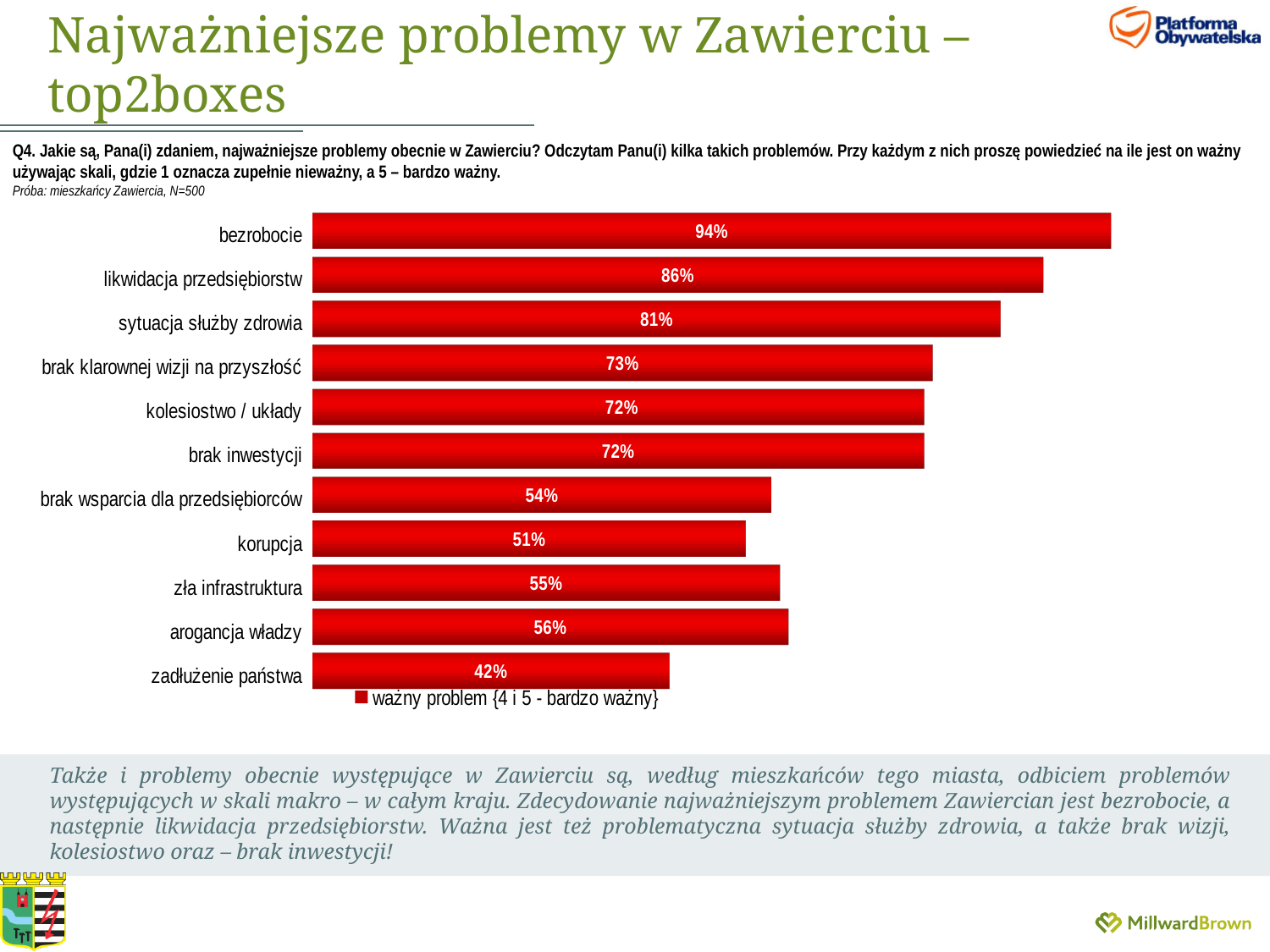
What is the value for bezrobocie? 94% What kind of chart is shown on the slide? bar chart How many categories are shown in the chart? 11 What is the value for zadłużenie państwa? 42% What is the value for sytuacja służby zdrowia? 81% Which category has the highest value? bezrobocie How many series does the legend list? 1 Which is larger, the value for korupcja or the value for arogancja władzy? arogancja władzy What is the difference between the values for brak klarownej wizji na przyszłość and brak wsparcia dla przedsiębiorców? 19% What is the legend entry for the series shown in the chart? ważny problem {4 i 5 - bardzo ważny} Which category has the lowest value? zadłużenie państwa What is the difference between the values for bezrobocie and likwidacja przedsiębiorstw? 8%